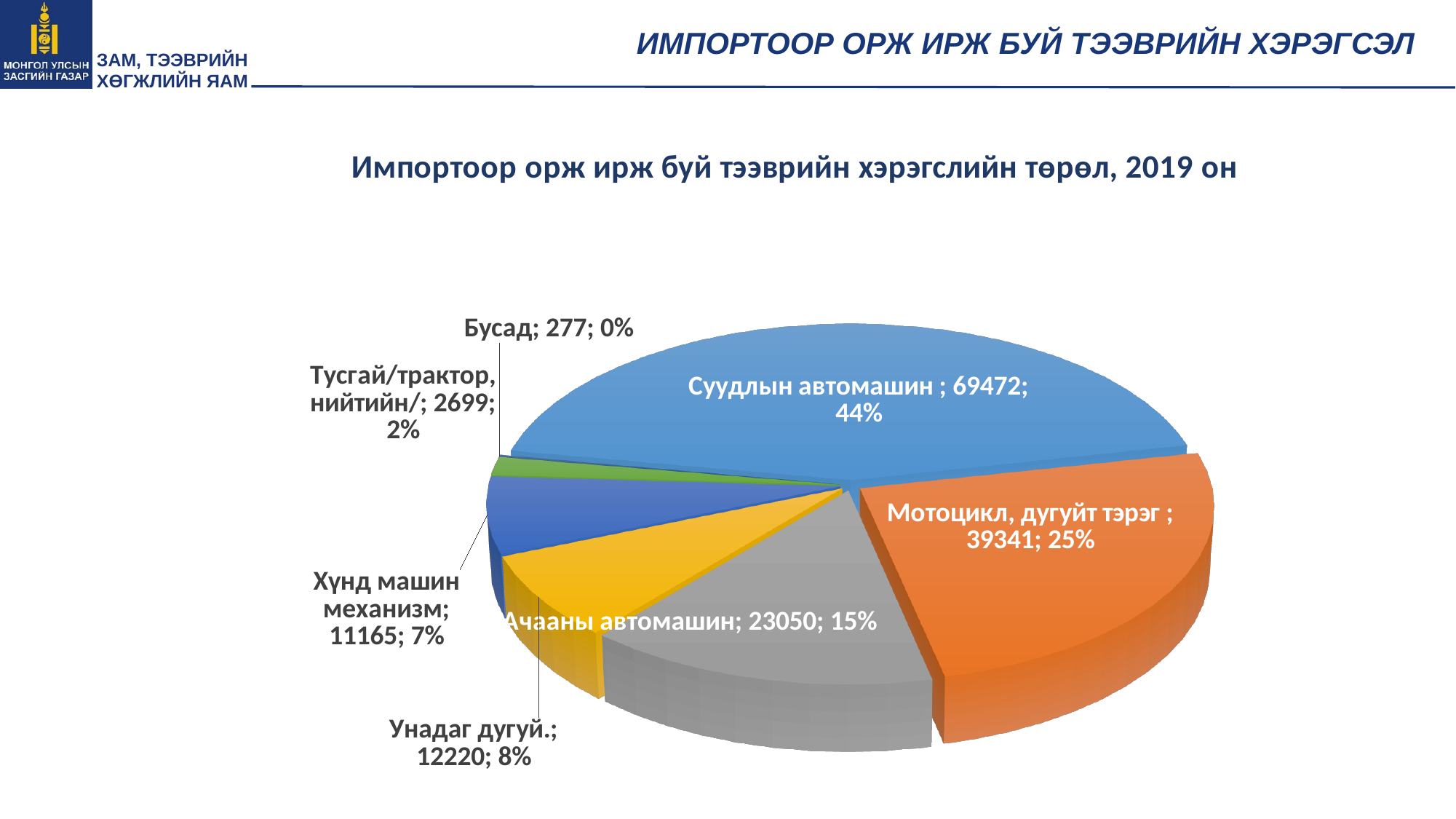
What is the value for Мотоцикл, дугуйт тэрэг? 39341 Which category has the smallest slice? Бусад What is the value for Суудлын автомашин? 69472 What share of the pie does Тусгай/трактор, нийтийн/ represent? 2% What share of the pie does Унадаг дугуй. represent? 8% What is the value for Ачааны автомашин? 23050 Which category has the largest slice? Суудлын автомашин How many categories are shown in the pie chart? 7 Which is larger, the value for Ачааны автомашин or the value for Унадаг дугуй.? Ачааны автомашин What type of chart is shown on the slide? Pie chart What is the value for Хүнд машин механизм? 11165 What is the difference between the values for Суудлын автомашин and Мотоцикл, дугуйт тэрэг? 30131